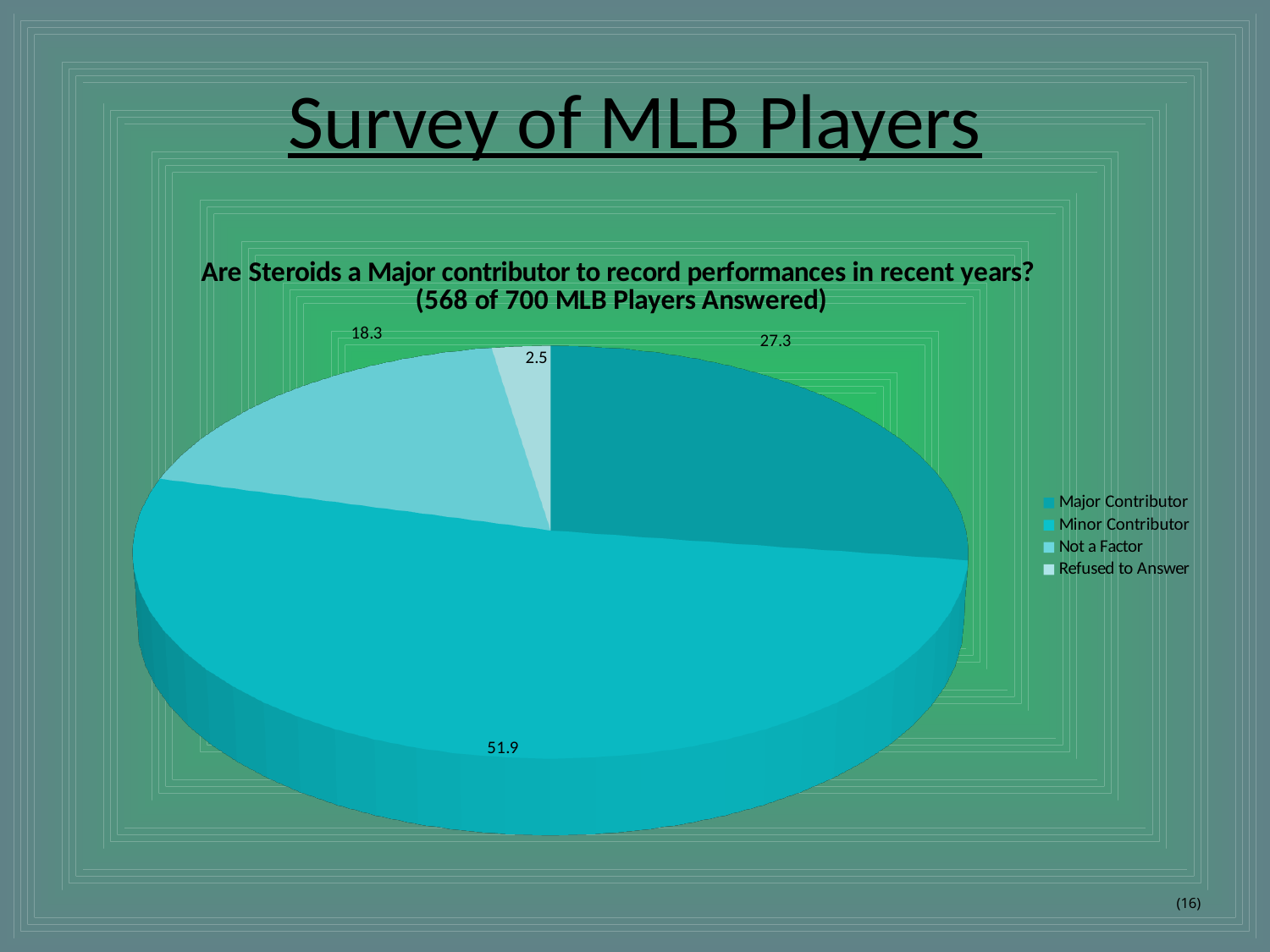
What is the value for Refused to Answer? 2.5 What is the difference between the values for Minor Contributor and Major Contributor? 24.6 Which is larger, the value for Major Contributor or the value for Not a Factor? Major Contributor What kind of chart is shown on the slide? pie chart How many categories does the pie chart have? 4 According to the chart title, how many of the 700 MLB players answered the survey? 568 What is the value for Minor Contributor? 51.9 Which category has the smallest slice of the pie? Refused to Answer Which category has the largest slice of the pie? Minor Contributor What is the value for Not a Factor? 18.3 What is the value for Major Contributor? 27.3 What is the difference between the values for Not a Factor and Refused to Answer? 15.8